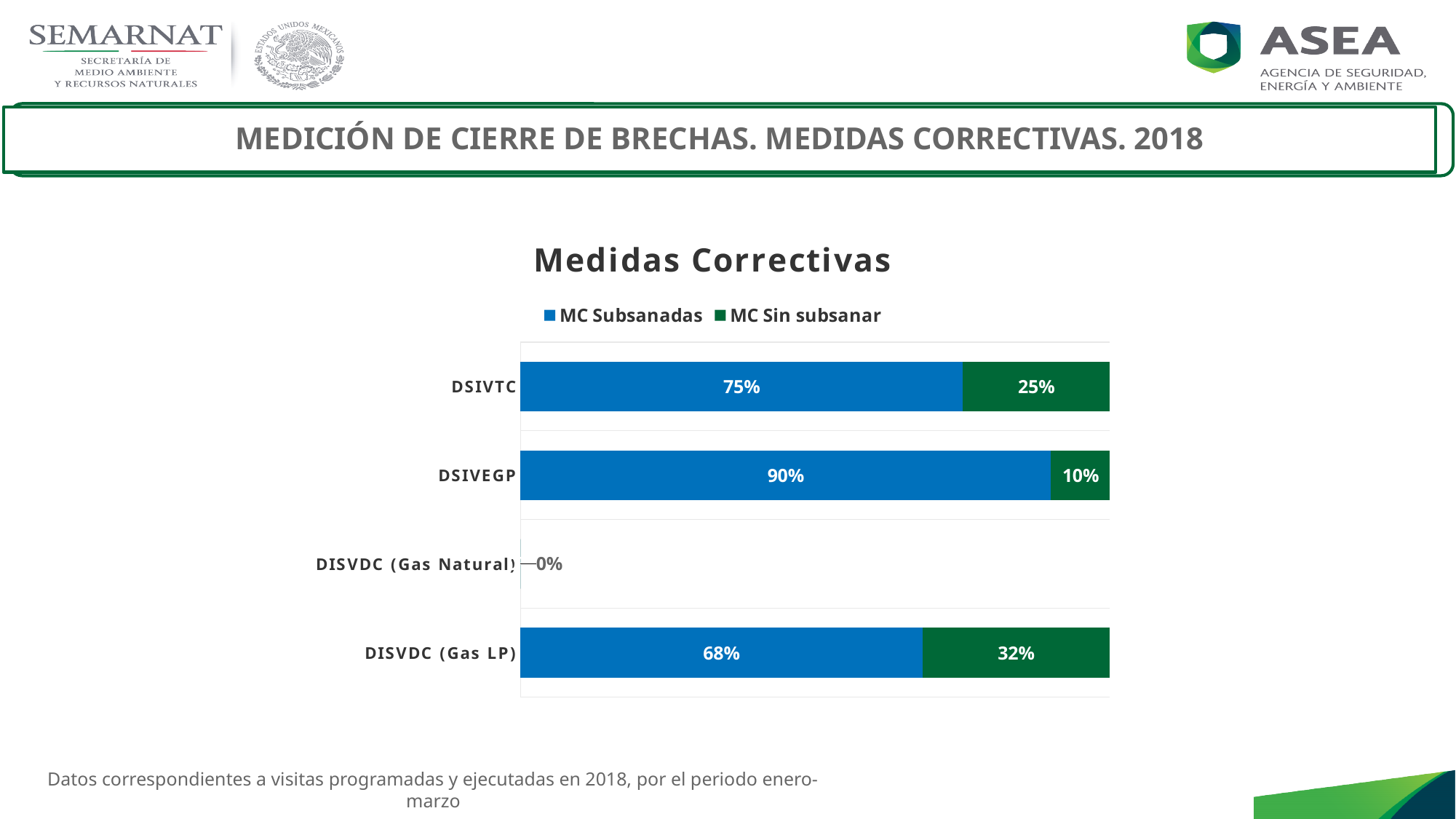
What is the value of MC Sin subsanar for DSIVEGP? 10% What is the difference between the MC Subsanadas values for DSIVEGP and DISVDC (Gas LP)? 22% What value is shown for DISVDC (Gas Natural)? 0% Which category has the highest MC Sin subsanar value? DISVDC (Gas LP) What kind of chart is shown? Stacked bar chart What is the value of MC Subsanadas for DSIVTC? 75% Which is larger: MC Sin subsanar for DSIVTC or for DSIVEGP? DSIVTC What is the value of MC Sin subsanar for DISVDC (Gas LP)? 32% How many series does the legend list? 2 What is the title of the chart? Medidas Correctivas How many categories are shown on the y axis? 4 Which category has the highest MC Subsanadas value? DSIVEGP